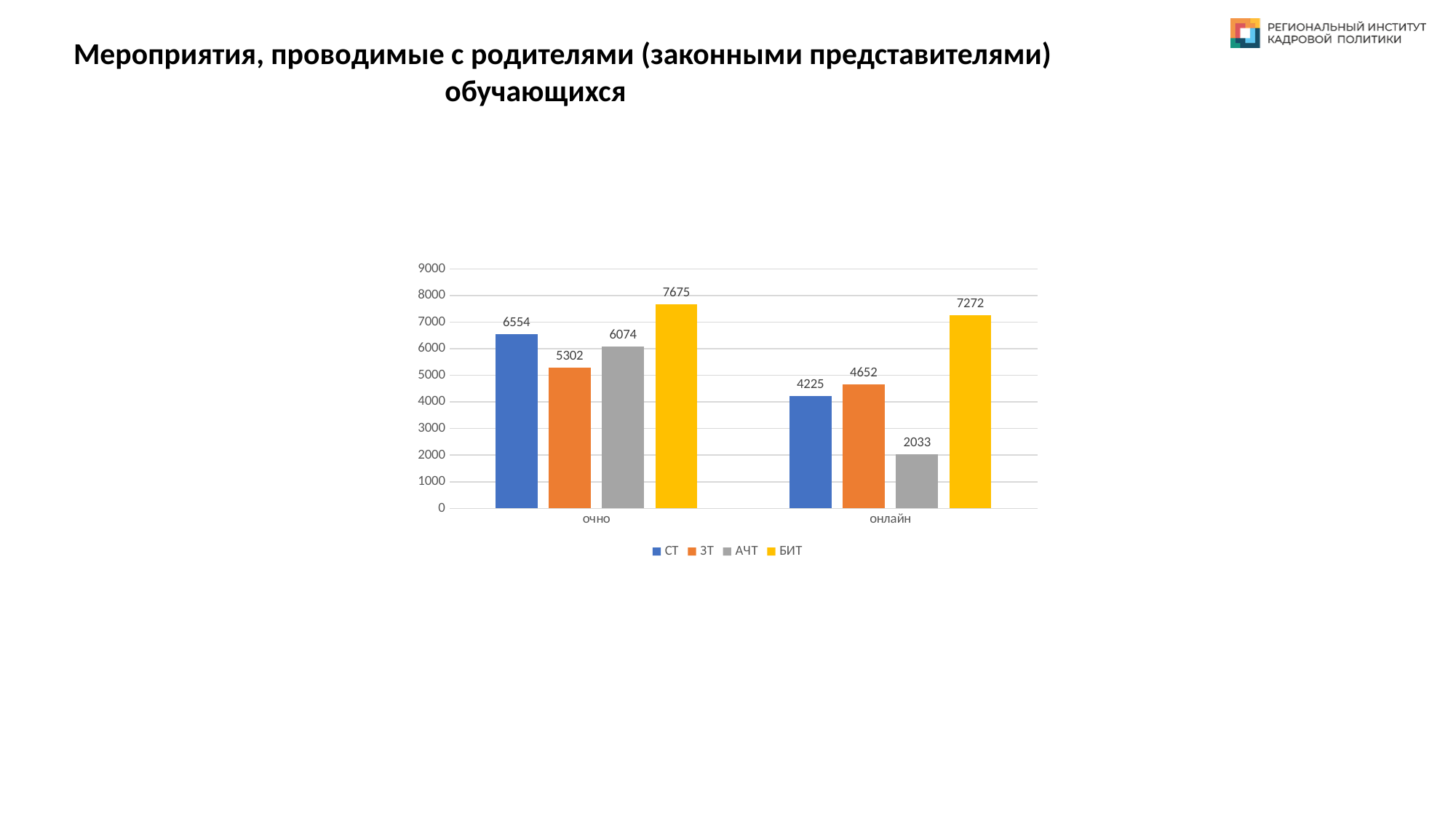
Which series has the highest value in the очно category? БИТ Which is larger: the ЗТ value for очно or the ЗТ value for онлайн? очно What is the difference between the БИТ values for очно and онлайн? 403 What kind of chart is shown on the slide? bar chart Which series has the lowest value in the онлайн category? АЧТ What colour are the bars for the БИТ series? yellow How many series does the legend list? 4 What is the value for АЧТ in the онлайн category? 2033 Is the value for АЧТ in the очно category greater or less than 5000? greater What is the value for СТ in the очно category? 6554 How many categories are shown on the x axis? 2 What is the value for БИТ in the онлайн category? 7272